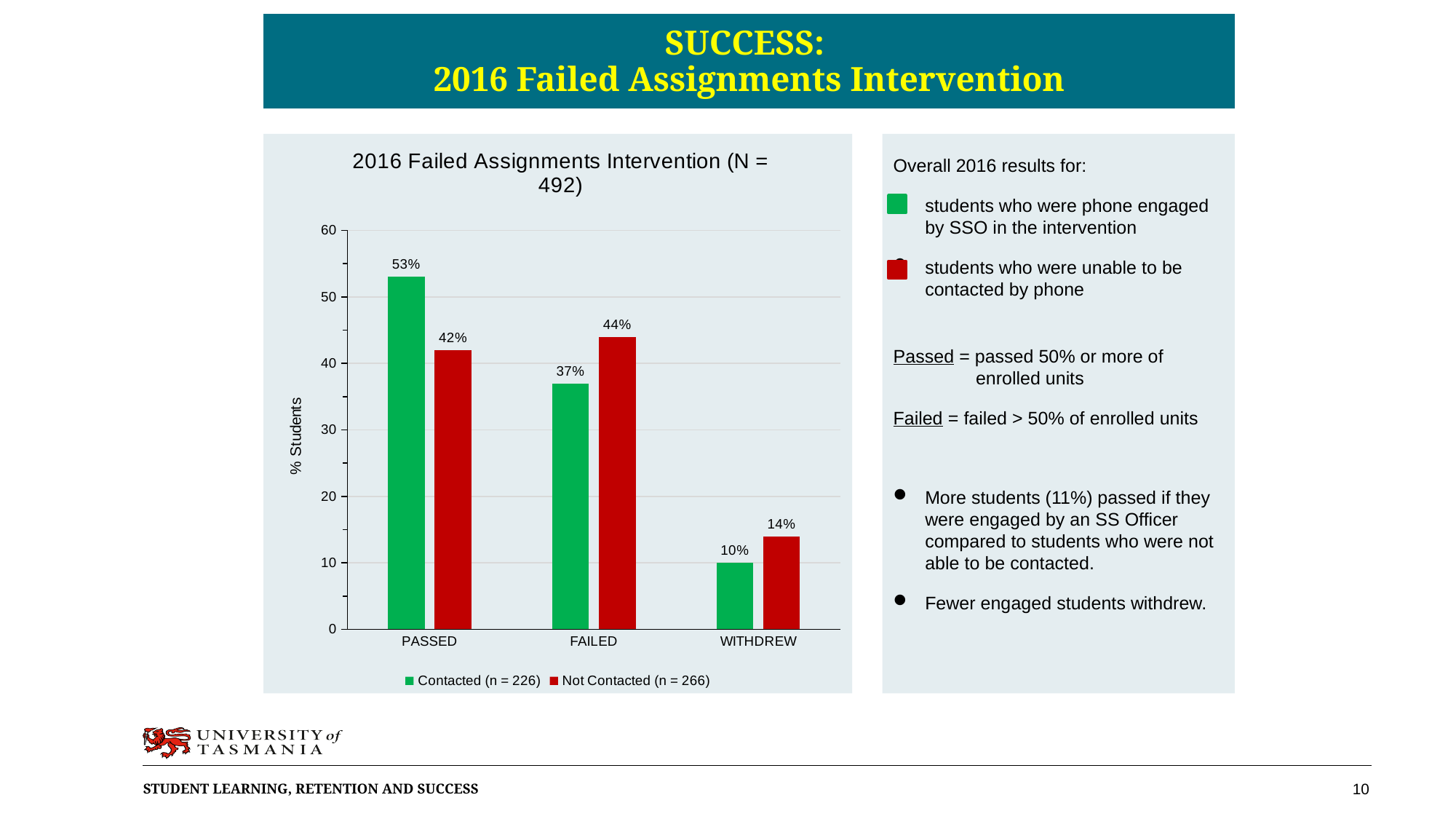
What percentage of Contacted (n = 226) students withdrew? 10% Is the Not Contacted (n = 266) value for WITHDREW greater or less than 20? less Which category has the highest value for the Not Contacted (n = 266) series? FAILED What is the difference between the Contacted and Not Contacted values for PASSED? 11% For FAILED, which series has the larger value, Contacted (n = 226) or Not Contacted (n = 266)? Not Contacted (n = 266) Which category has the lowest value for the Contacted (n = 226) series? WITHDREW How many categories are shown on the x axis? 3 What kind of chart is shown on the slide? Bar chart How many series does the legend list? 2 What percentage of Not Contacted (n = 266) students failed? 44% What is the label of the y axis? % Students What percentage of Contacted (n = 226) students passed? 53%